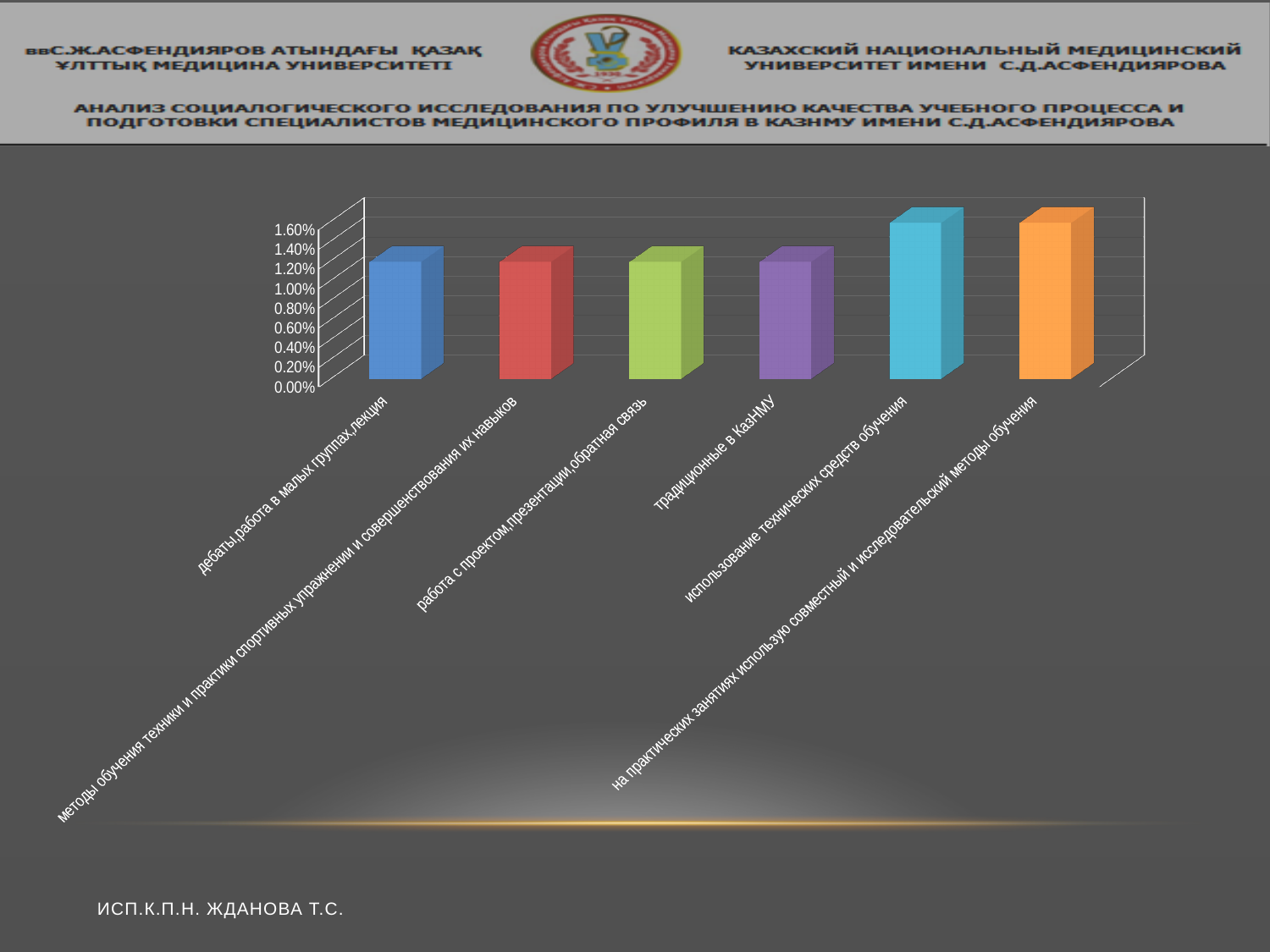
What colour is the bar for 'традиционные в КазНМУ'? purple Is the value for 'традиционные в КазНМУ' greater or less than 1.00%? greater What is the highest tick value shown on the vertical axis of the chart? 1.60% Is the value for 'работа с проектом,презентации,обратная связь' greater or less than 0.60%? greater How many categories are plotted in the chart? 6 Is the value for 'использование технических средств обучения' greater or less than 1.40%? greater What kind of chart is shown on the slide? bar chart Which is larger: the value for 'использование технических средств обучения' or the value for 'дебаты,работа в малых группах,лекция'? использование технических средств обучения Which is larger: the value for 'традиционные в КазНМУ' or the value for 'на практических занятиях использую совместный и исследовательский методы обучения'? на практических занятиях использую совместный и исследовательский методы обучения